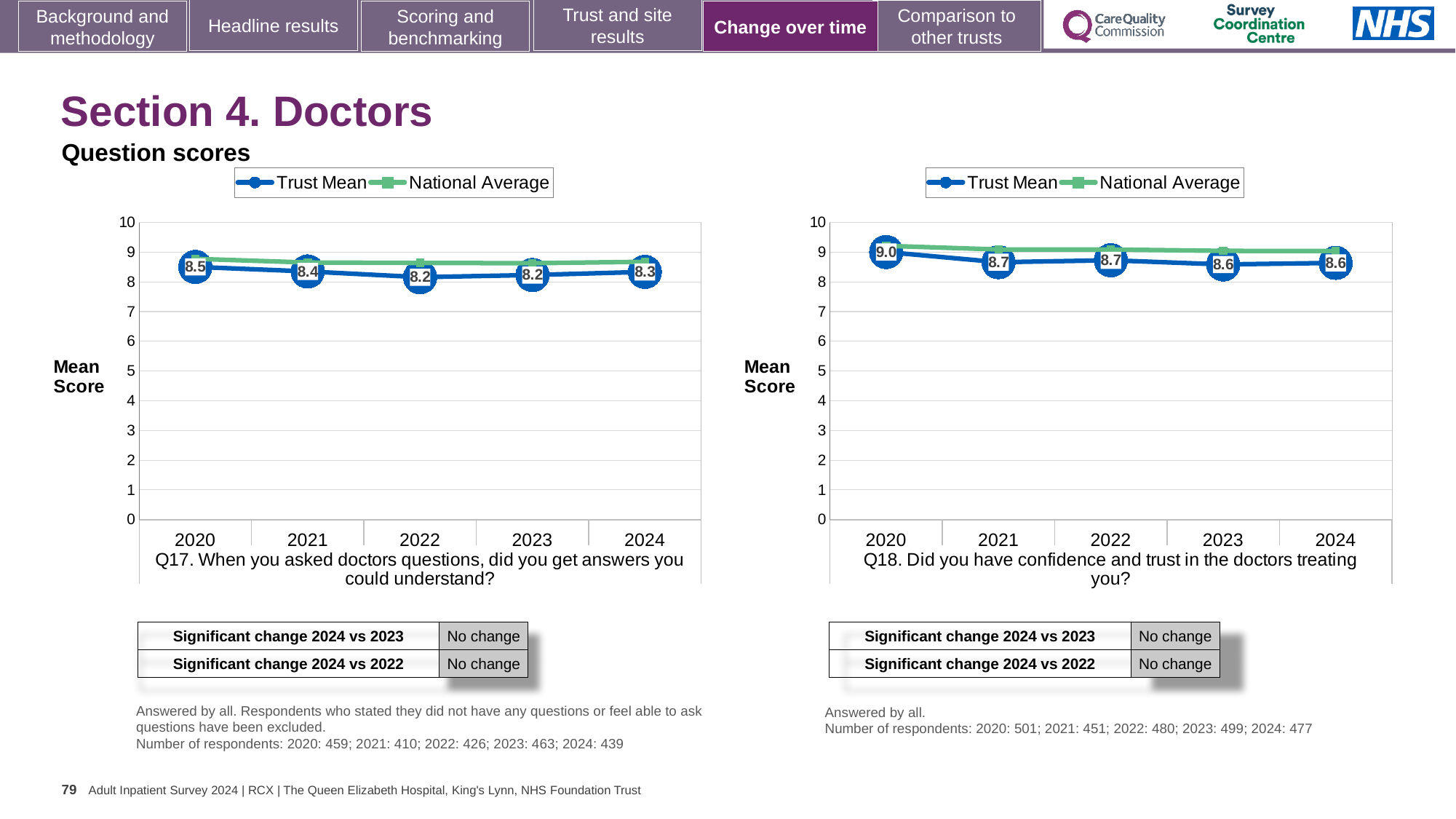
In the Q17 chart on the left, is the Trust Mean score higher in 2020 or in 2022? 2020 In the Q18 chart on the right, does the Trust Mean score rise or fall from 2020 to 2024? fall In the Q18 chart on the right, what is the difference between the Trust Mean scores for 2020 and 2021? 0.3 In the Q18 chart on the right, which year has the highest Trust Mean score? 2020 In the Q17 chart on the left, which year has the highest Trust Mean score? 2020 In the Q18 chart on the right, what is the Trust Mean score for 2021? 8.7 In the Q17 chart on the left, what is the difference between the Trust Mean scores for 2020 and 2024? 0.2 In the Q17 chart on the left, what is the Trust Mean score for 2024? 8.3 How many series does the legend of the Q18 chart on the right list? 2 In the Q18 chart on the right, is the National Average value for 2024 greater or less than 8? greater In the Q17 chart on the left, what is the Trust Mean score for 2020? 8.5 How many years are shown on the x axis of the Q17 chart on the left? 5